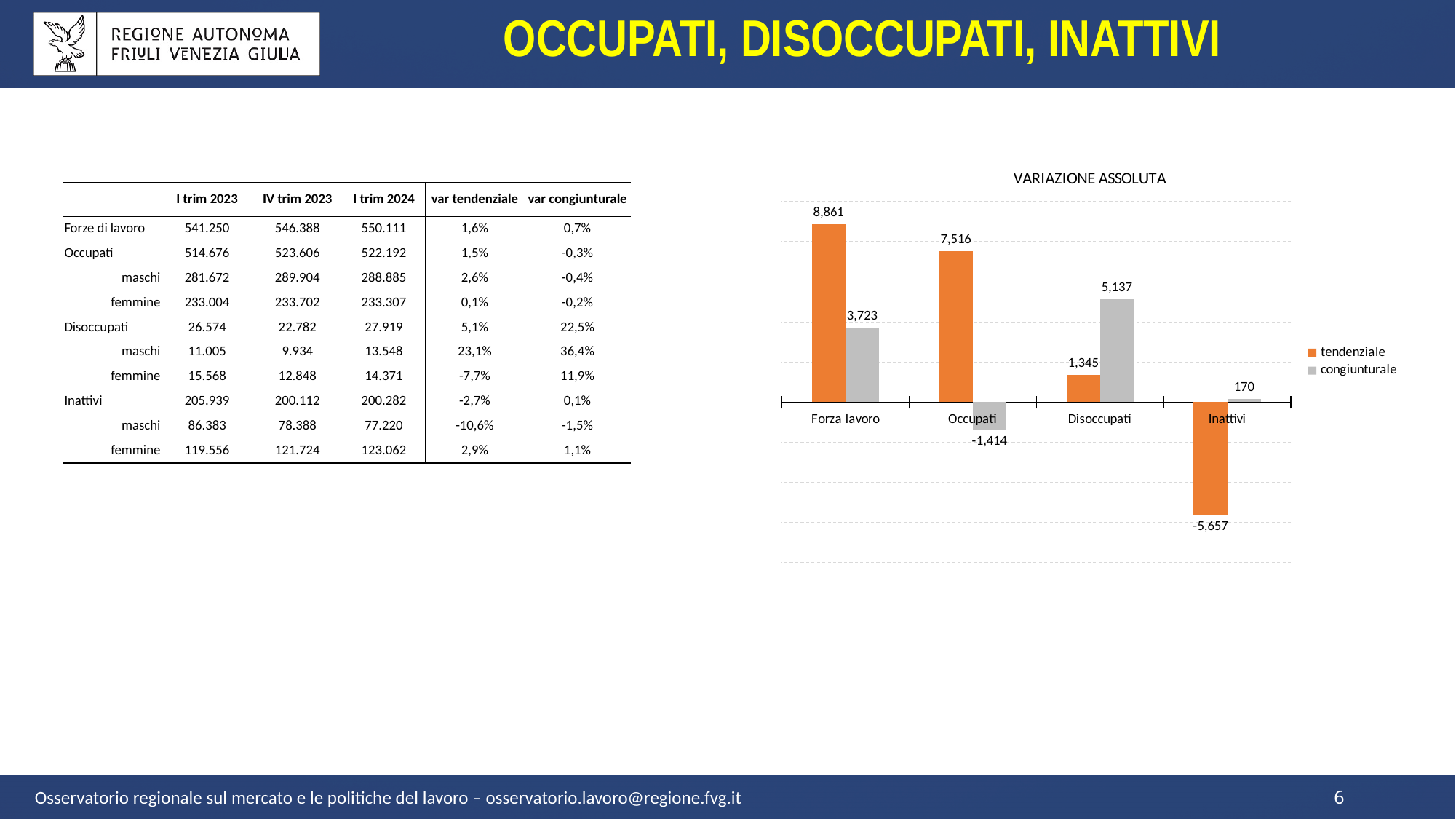
How many series does the legend of the VARIAZIONE ASSOLUTA chart list? 2 In the VARIAZIONE ASSOLUTA chart, what is the tendenziale value for Inattivi? -5,657 In the VARIAZIONE ASSOLUTA chart, which category has the lowest congiunturale value? Occupati In the VARIAZIONE ASSOLUTA chart, which is larger for Disoccupati: the tendenziale or the congiunturale value? congiunturale In the VARIAZIONE ASSOLUTA chart, which colour represents the tendenziale series? orange In the VARIAZIONE ASSOLUTA chart, what is the congiunturale value for Disoccupati? 5,137 In the VARIAZIONE ASSOLUTA chart, what is the difference between the tendenziale and congiunturale values for Forza lavoro? 5,138 In the VARIAZIONE ASSOLUTA chart, which category has the highest tendenziale value? Forza lavoro In the VARIAZIONE ASSOLUTA chart, what is the tendenziale value for Forza lavoro? 8,861 In the VARIAZIONE ASSOLUTA chart, what is the congiunturale value for Occupati? -1,414 What type of chart is shown under the title VARIAZIONE ASSOLUTA? bar chart How many categories are shown on the x axis of the VARIAZIONE ASSOLUTA chart? 4